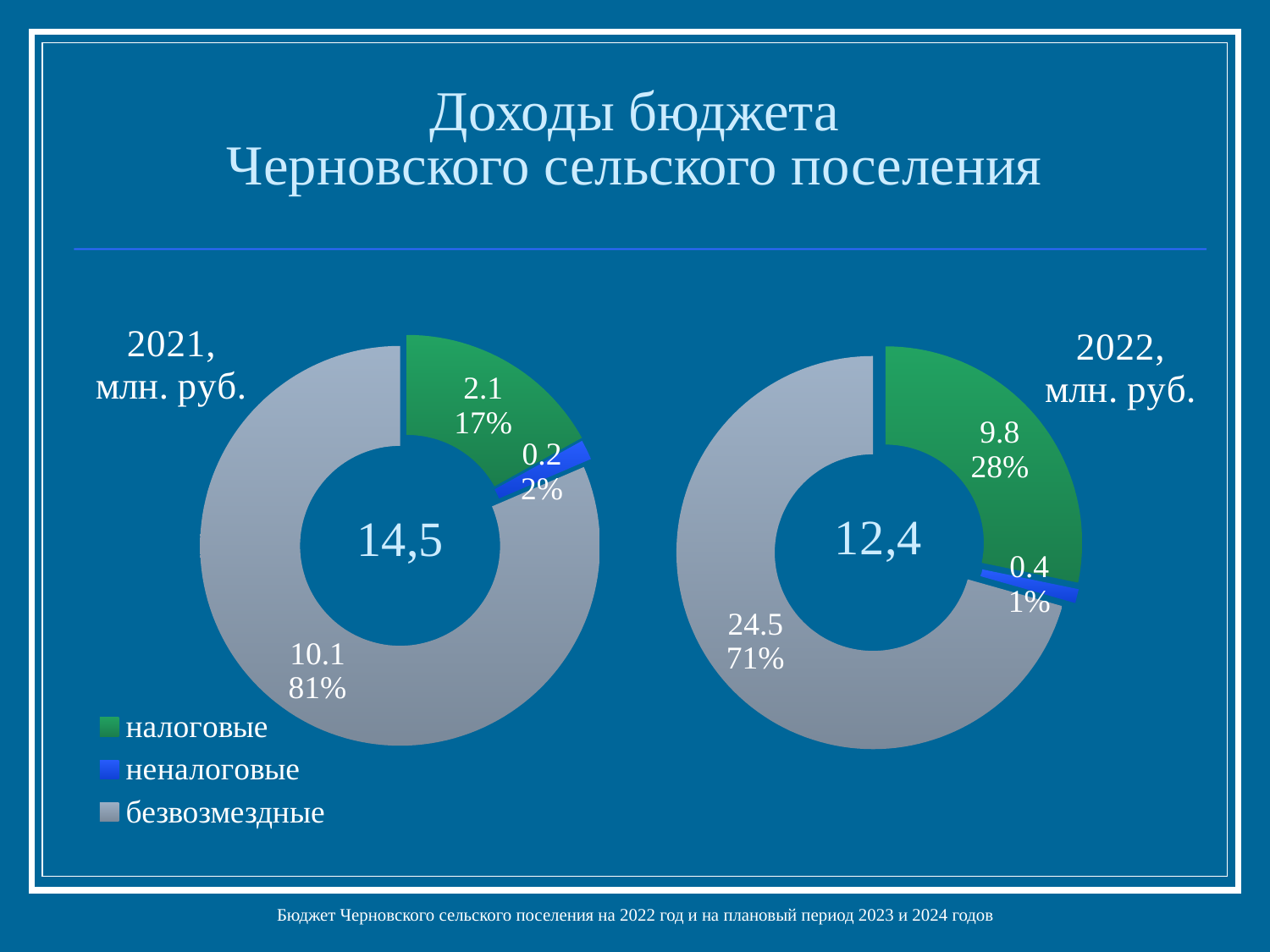
On the 2022 chart, what value is shown for безвозмездные? 24.5 On the 2022 chart, what is the difference between the values for безвозмездные and налоговые? 14.7 On the 2021 chart, what value is shown for налоговые? 2.1 How many categories does the legend list? 3 On the 2021 chart, which category has the largest share? безвозмездные What number is shown in the centre of the 2021 chart? 14,5 What kind of chart is used on this slide? doughnut (pie) chart Which is larger: the value for налоговые on the 2021 chart or on the 2022 chart? 2022 On the 2022 chart, what percentage is shown for налоговые? 28% On the 2022 chart, which category has the smallest share? неналоговые What colour represents неналоговые in the legend? blue On the 2021 chart, what percentage is shown for безвозмездные? 81%